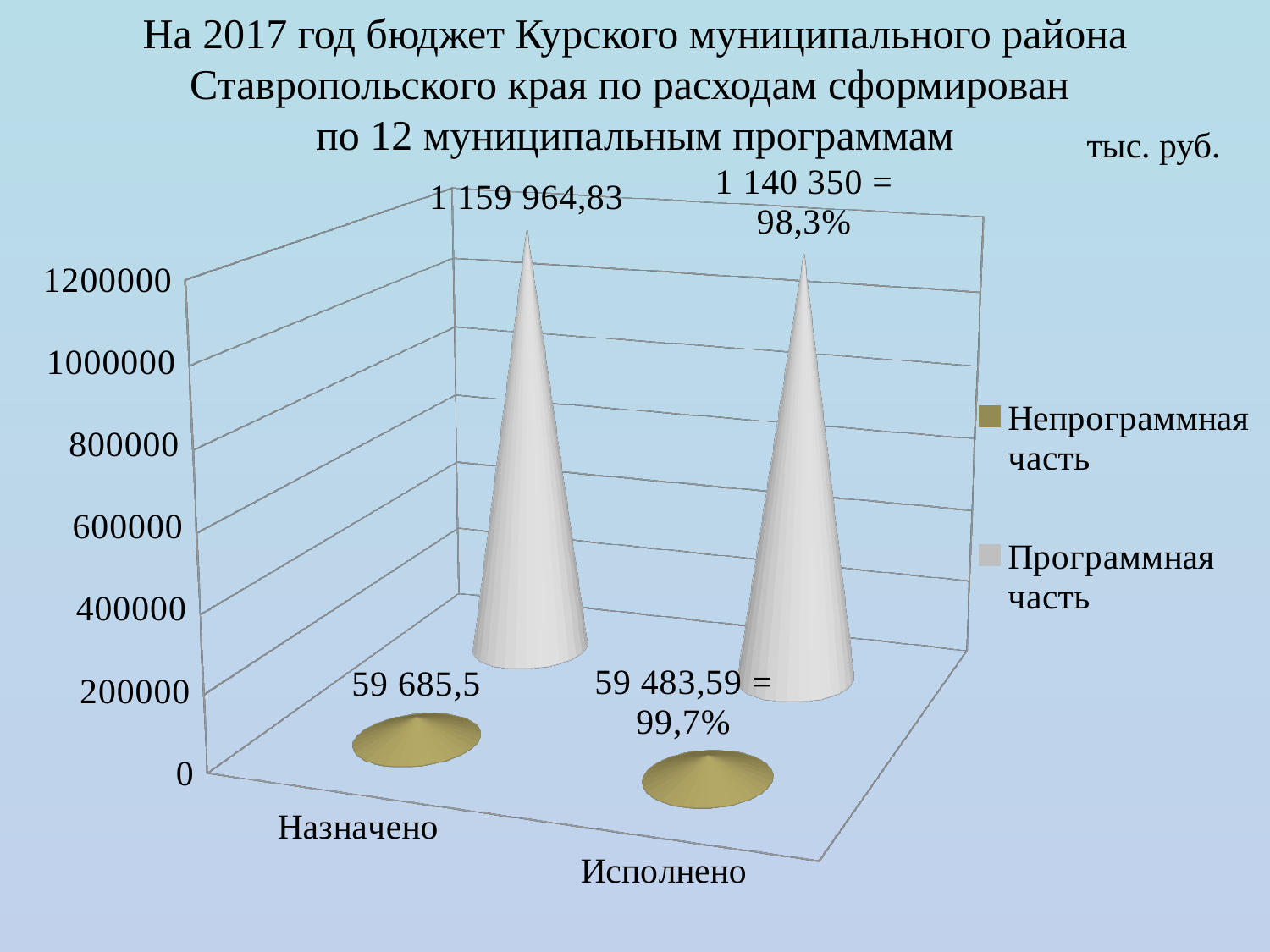
What percentage is shown next to the Исполнено value for Непрограммная часть? 99,7% What value is shown for Непрограммная часть in the Исполнено category? 59 483,59 What value is shown for Программная часть in the Назначено category? 1 159 964,83 What unit is indicated in the top right corner of the chart? тыс. руб. How many series does the legend list? 2 What value is shown for Непрограммная часть in the Назначено category? 59 685,5 What value is shown for Программная часть in the Исполнено category? 1 140 350 Is the value for Программная часть in Назначено greater or less than 1000000? greater What percentage is shown next to the Исполнено value for Программная часть? 98,3% Which is larger for Непрограммная часть: the Назначено value or the Исполнено value? Назначено What is the difference between the Назначено and Исполнено values for Программная часть? 19 614,83 How many categories are shown on the x axis? 2